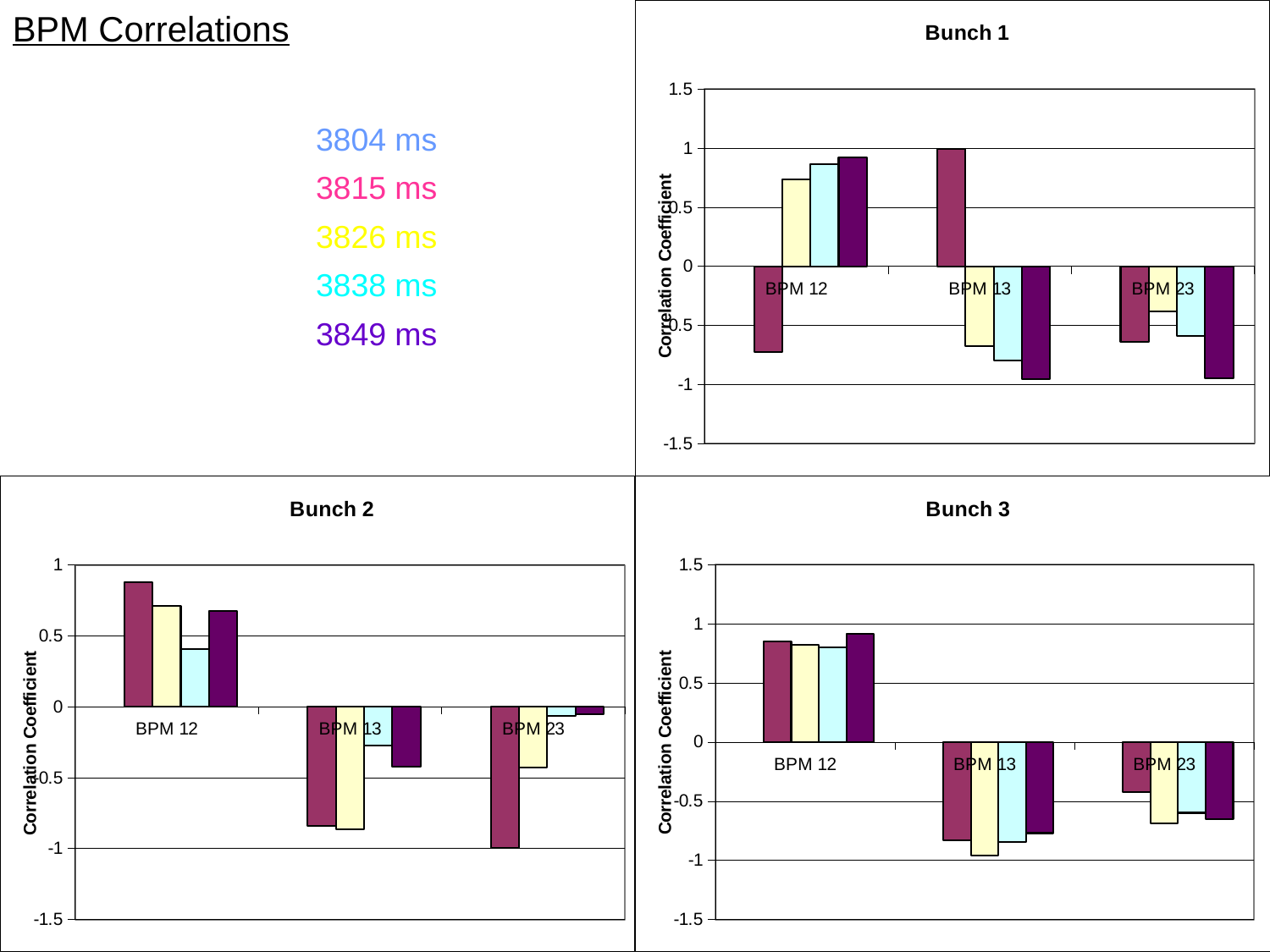
What kind of chart is the Bunch 1 chart? bar chart In the Bunch 2 chart, is the value of the first (dark pink) bar for BPM 23 greater or less than -0.5? less What is the y-axis title of the Bunch 3 chart? Correlation Coefficient In the Bunch 1 chart, is the value of the first (dark pink) bar for BPM 13 greater or less than 0.5? greater In the Bunch 2 chart, is the value of the first (dark pink) bar for BPM 12 greater or less than 0.5? greater How many bars are plotted for each BPM category in the Bunch 3 chart? 4 What is the highest value labelled on the y axis of the Bunch 2 chart? 1 How many categories are shown on the x axis of the Bunch 2 chart? 3 In the Bunch 2 chart, which BPM category has all of its bars above zero? BPM 12 In the Bunch 2 chart, for BPM 12, which is larger: the first (dark pink) bar or the third (light blue) bar? the first (dark pink) bar